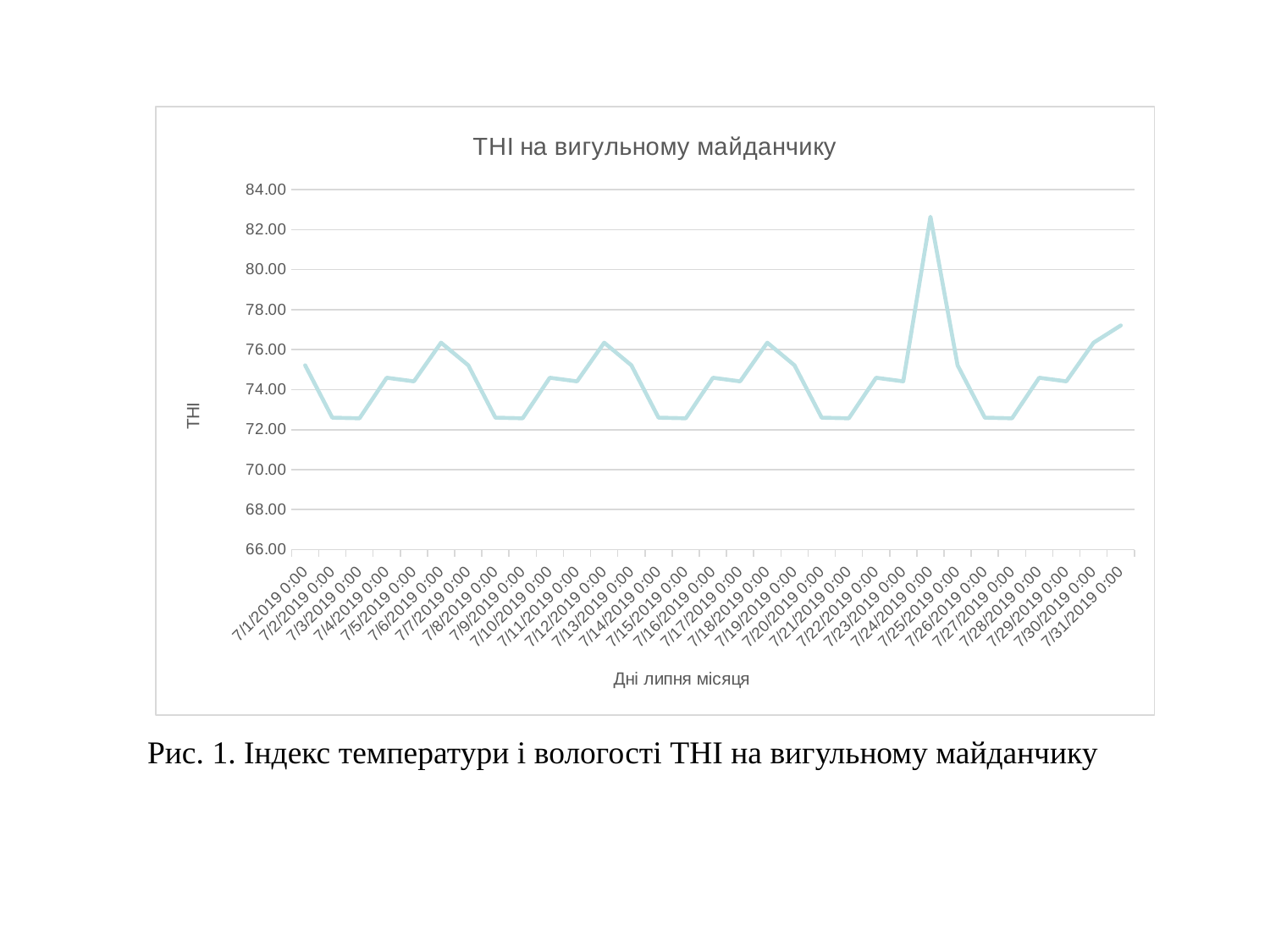
Does the THI rise or fall from 7/22/2019 0:00 to 7/24/2019 0:00? rise What is the label of the x axis? Дні липня місяця Which date has the larger THI value, 7/31/2019 0:00 or 7/26/2019 0:00? 7/31/2019 0:00 What is the title of the chart? THI на вигульному майданчику How many dates are plotted along the x axis? 31 What kind of chart is shown on the slide? line chart Which date has the larger THI value, 7/24/2019 0:00 or 7/2/2019 0:00? 7/24/2019 0:00 Is the THI value for 7/1/2019 0:00 greater or less than 74.00? greater Is the THI value for 7/2/2019 0:00 greater or less than 74.00? less Is the THI value for 7/24/2019 0:00 greater or less than 80.00? greater On which date does the THI reach its highest value? 7/24/2019 0:00